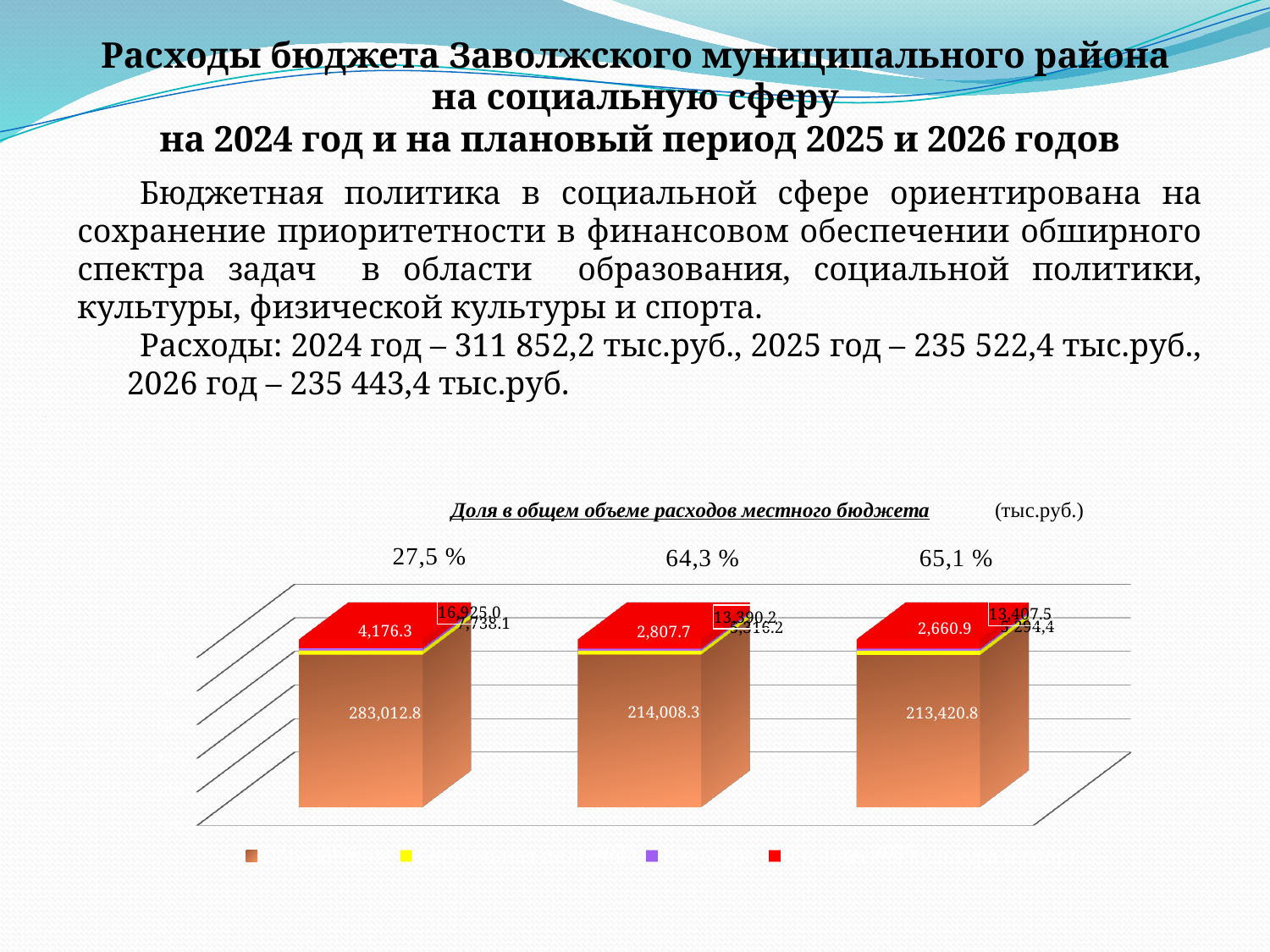
Which bar has the largest orange bottom segment? the left bar What percentage is printed above the left bar? 27,5 % How many bars are plotted in the chart? 3 How many series does the chart legend list? 4 What kind of chart is shown on the slide? bar chart What is the value of the large orange bottom segment of the right bar? 213,420.8 What is the difference between the orange bottom segments of the left bar (283,012.8) and the middle bar (214,008.3)? 69,004.5 What is the value of the large orange bottom segment of the left bar? 283,012.8 What is the value of the large orange bottom segment of the middle bar? 214,008.3